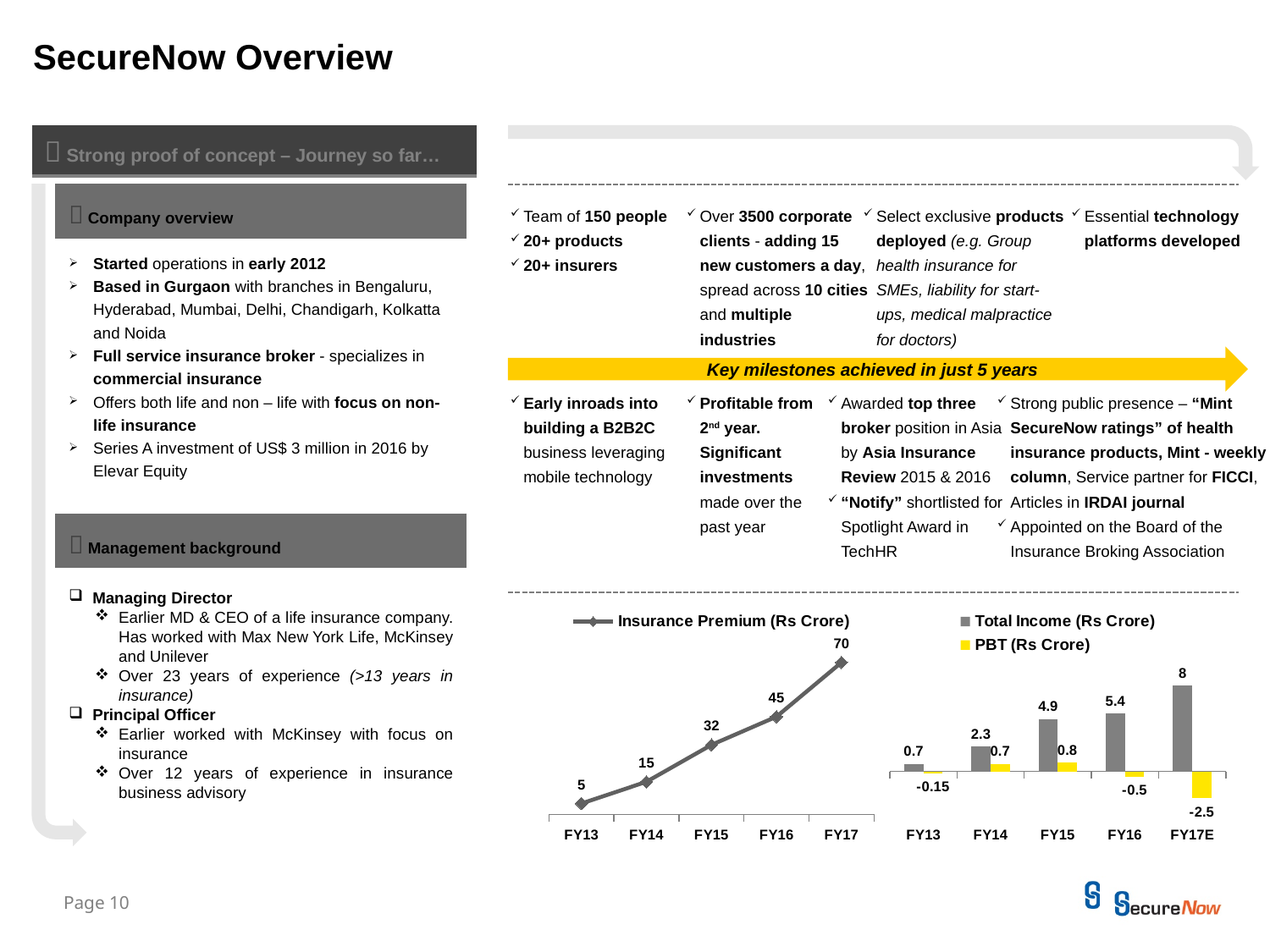
In the Insurance Premium (Rs Crore) chart, do the values rise or fall from FY13 to FY17? rise In the Insurance Premium (Rs Crore) chart, which fiscal year has the lowest value? FY13 What kind of chart is the Insurance Premium (Rs Crore) chart? line chart In the Total Income / PBT chart on the right, how many series does the legend list? 2 In the Insurance Premium (Rs Crore) chart, what is the difference between the FY17 and FY16 values? 25 In the Total Income / PBT chart on the right, what is the Total Income (Rs Crore) for FY16? 5.4 In the Insurance Premium (Rs Crore) chart, what is the value for FY15? 32 In the Total Income / PBT chart on the right, is the Total Income for FY14 larger or smaller than the Total Income for FY15? smaller In the Insurance Premium (Rs Crore) chart, what is the value for FY17? 70 In the Total Income / PBT chart on the right, what is the PBT (Rs Crore) for FY17E? -2.5 In the Total Income / PBT chart on the right, which fiscal year has the highest Total Income (Rs Crore)? FY17E In the Total Income / PBT chart on the right, which fiscal year has the lowest PBT (Rs Crore)? FY17E